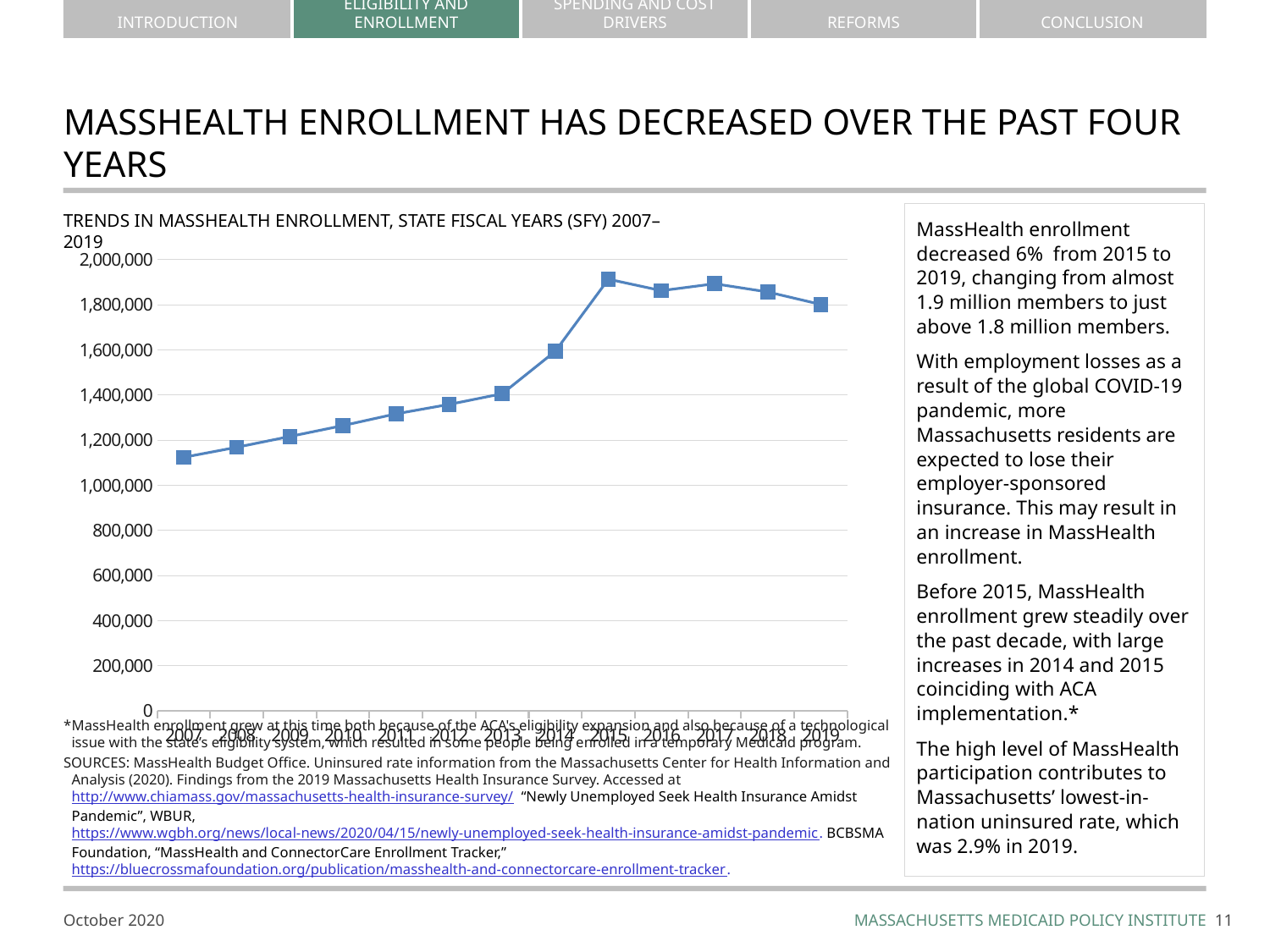
Which year has the highest MassHealth enrollment on the chart? 2015 Which year has higher enrollment, 2013 or 2014? 2014 Is the enrollment value for 2014 greater or less than 1,400,000? greater How many years (data points) are plotted on the chart? 13 Which year has higher enrollment, 2015 or 2019? 2015 Do enrollment values rise or fall from 2007 to 2015? rise What is the title of the chart? Trends in MassHealth Enrollment, State Fiscal Years (SFY) 2007–2019 Is the enrollment value for 2007 greater or less than 1,200,000? less Is the enrollment value for 2013 greater or less than 1,600,000? less Which year has the lowest MassHealth enrollment on the chart? 2007 What kind of chart is shown on the slide? Line chart